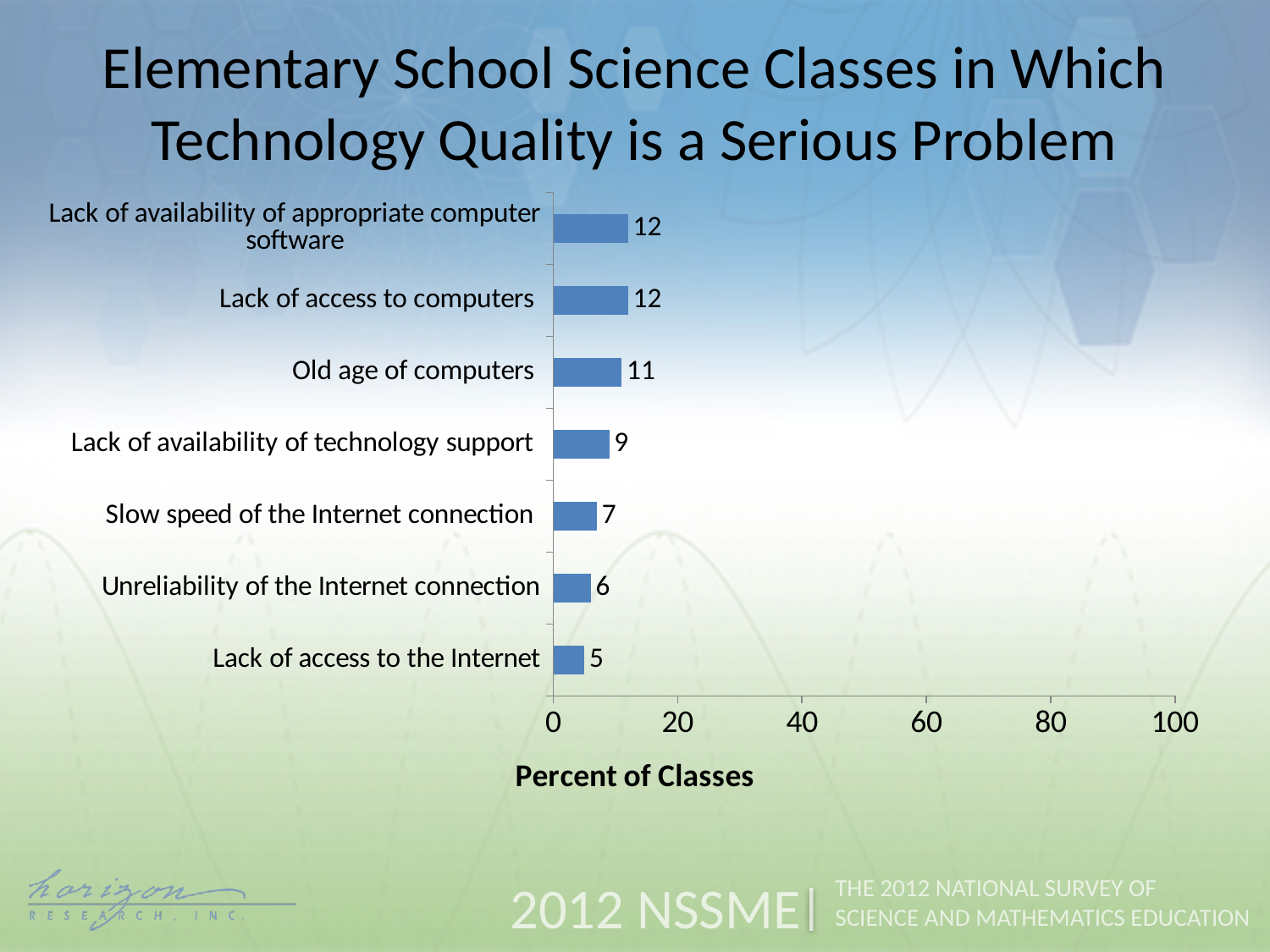
Which is larger, the value for Lack of availability of technology support or the value for Slow speed of the Internet connection? Lack of availability of technology support What is the value for Old age of computers? 11 What is the value for Lack of availability of technology support? 9 What is the value for Slow speed of the Internet connection? 7 How many categories are shown in the chart? 7 What is the difference between the values for Lack of access to computers and Lack of access to the Internet? 7 Is the value for Lack of access to computers greater or less than 20? less What kind of chart is shown on the slide? bar chart What is the difference between the values for Old age of computers and Unreliability of the Internet connection? 5 What is the label of the horizontal axis? Percent of Classes Which category has the lowest value? Lack of access to the Internet What is the value for Lack of access to the Internet? 5